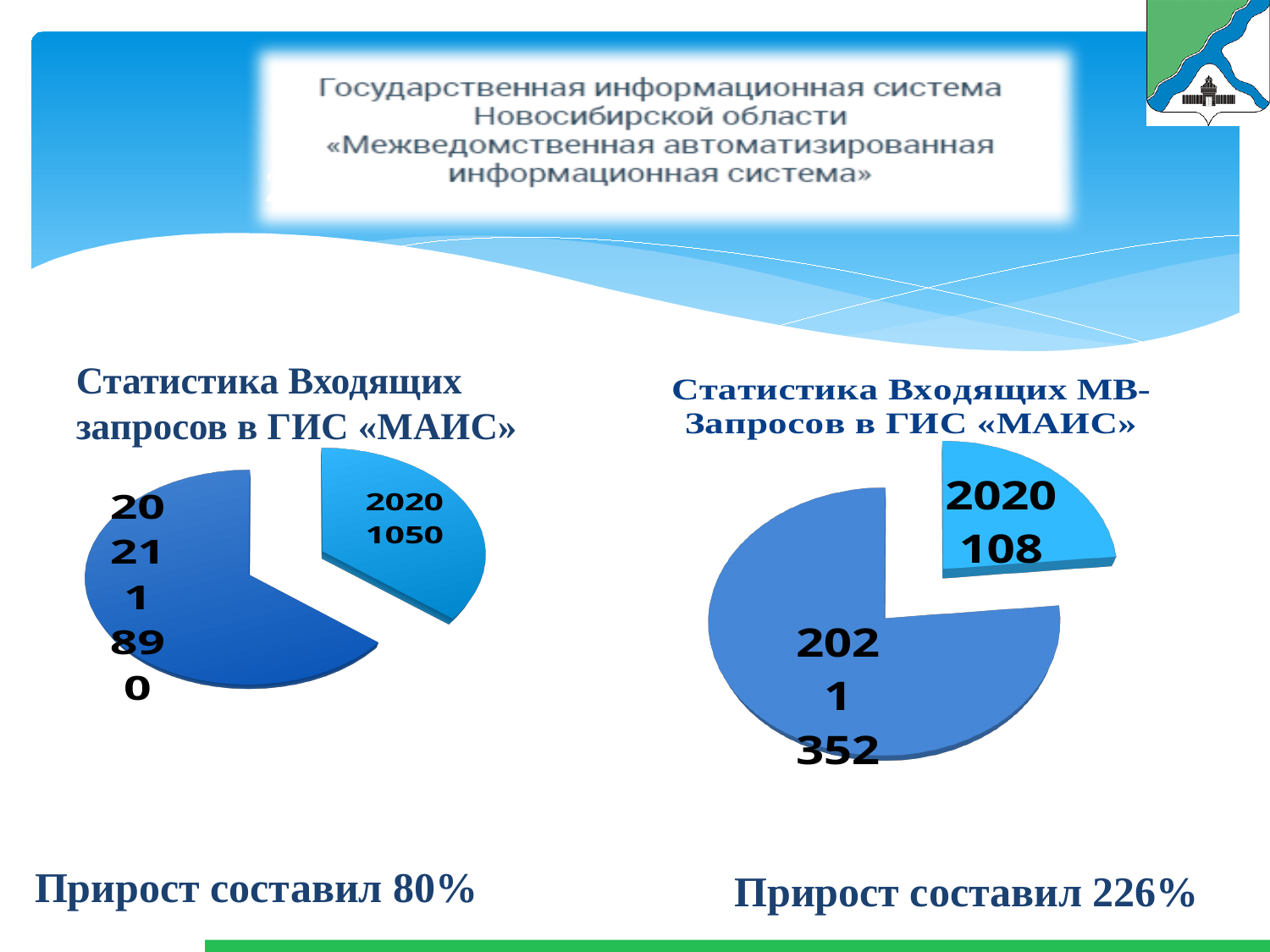
What is the total of the two values shown in the right chart? 460 In the right chart (Статистика Входящих МВ-Запросов в ГИС «МАИС»), what is the value for 2020? 108 In the right chart, what is the difference between the 2021 and 2020 values? 244 In the left chart (Статистика Входящих запросов в ГИС «МАИС»), what is the value for 2020? 1050 In the left chart, what is the difference between the 2021 and 2020 values? 840 In the left chart (Статистика Входящих запросов в ГИС «МАИС»), what is the value for 2021? 1890 What type of chart is used on the left side of the slide? Pie chart In the right chart, which year has the smaller value? 2020 How many slices does the right chart (Статистика Входящих МВ-Запросов в ГИС «МАИС») have? 2 In the right chart, is the value for 2021 larger or smaller than the value for 2020? larger In the right chart (Статистика Входящих МВ-Запросов в ГИС «МАИС»), what is the value for 2021? 352 In the left chart, which year has the larger value? 2021